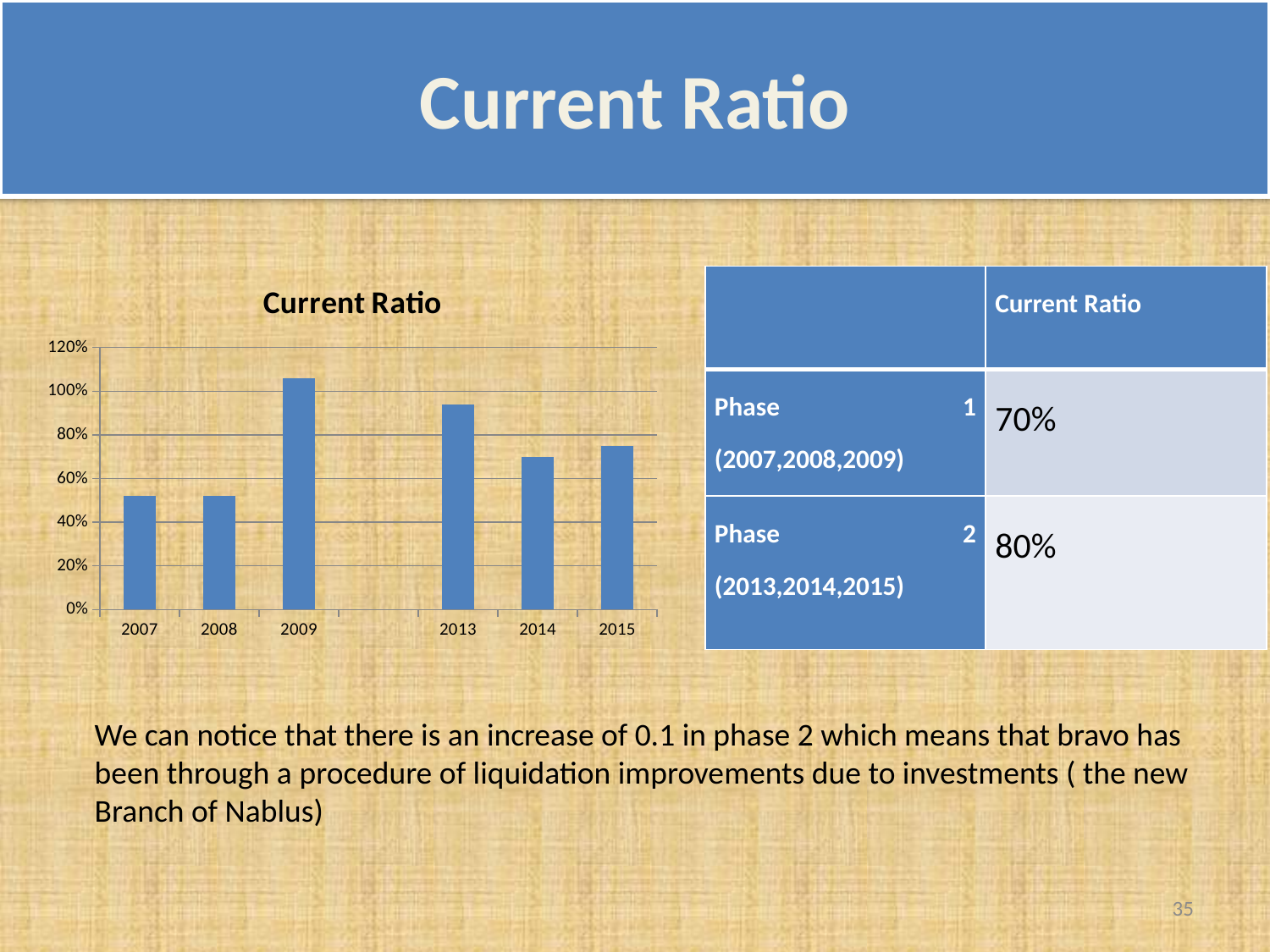
Which year has the highest current ratio in the chart? 2009 Is the value for 2013 greater or less than 80%? greater Is the value for 2014 greater or less than 80%? less Which is larger, the value for 2013 or the value for 2014? 2013 What kind of chart is shown on the slide? bar chart How many years are shown on the x axis of the chart? 6 What is the title of the chart? Current Ratio Is the value for 2009 greater or less than 100%? greater Do the values rise or fall from 2007 to 2009? rise Which is larger, the value for 2009 or the value for 2013? 2009